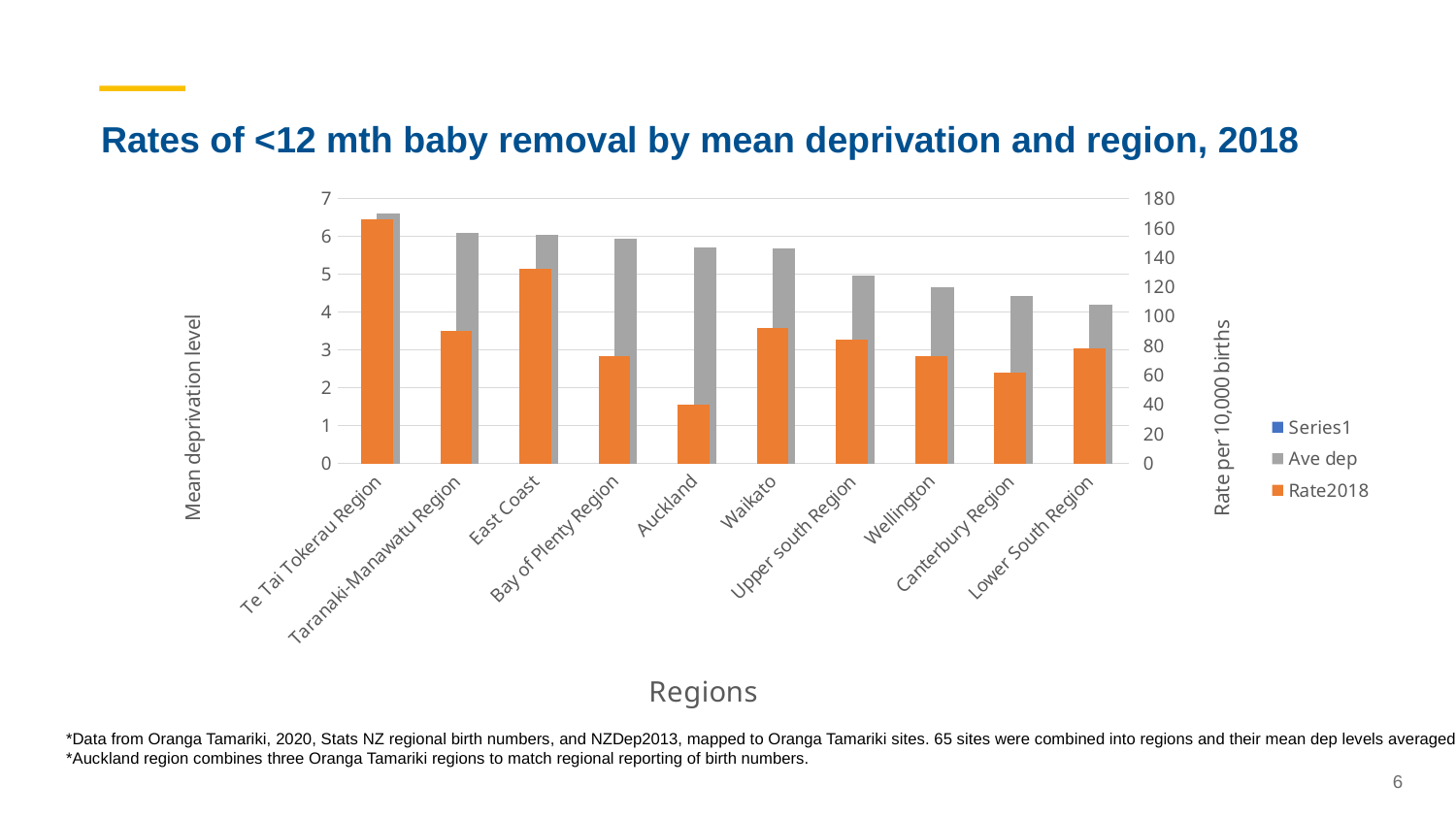
Is the Rate2018 value for Te Tai Tokerau Region greater or less than 140 on the right axis? greater Which region has the larger Rate2018 value, East Coast or Taranaki-Manawatu Region? East Coast How many regions are shown along the x axis of the chart? 10 Is the Rate2018 value for Auckland greater or less than 60 on the right axis? less Which region has the highest Ave dep value? Te Tai Tokerau Region What is the label on the right-hand vertical axis of the chart? Rate per 10,000 births Which region has the highest Rate2018 value? Te Tai Tokerau Region Is the Ave dep value for Wellington greater or less than 5 on the left axis? less Do the Ave dep values generally rise or fall moving from left to right across the regions? Fall What kind of chart is shown on the slide? Bar chart How many series does the chart's legend list? 3 Which region has the lowest Rate2018 value? Auckland